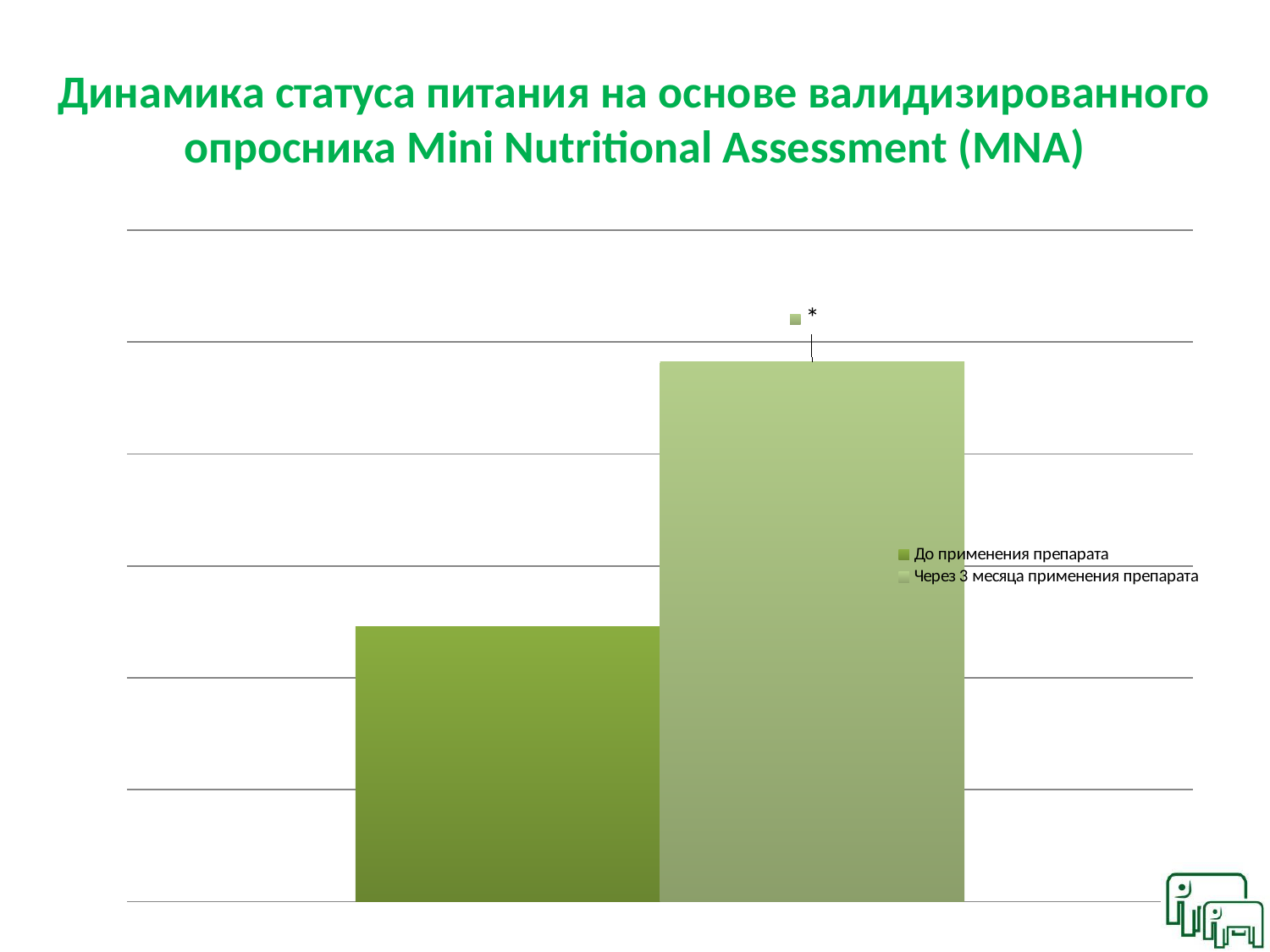
Does the value rise or fall from "До применения препарата" to "Через 3 месяца применения препарата"? Rise Which series has the highest value in the chart? Через 3 месяца применения препарата Which series has the lowest value in the chart? До применения препарата How many series does the legend list? 2 What is the title of the slide containing the chart? Динамика статуса питания на основе валидизированного опросника Mini Nutritional Assessment (MNA) What kind of chart is shown on the slide? Bar chart How many bars are plotted in the chart? 2 Which series has the taller bar: "До применения препарата" or "Через 3 месяца применения препарата"? Через 3 месяца применения препарата What symbol is placed above the bar for "Через 3 месяца применения препарата"? *